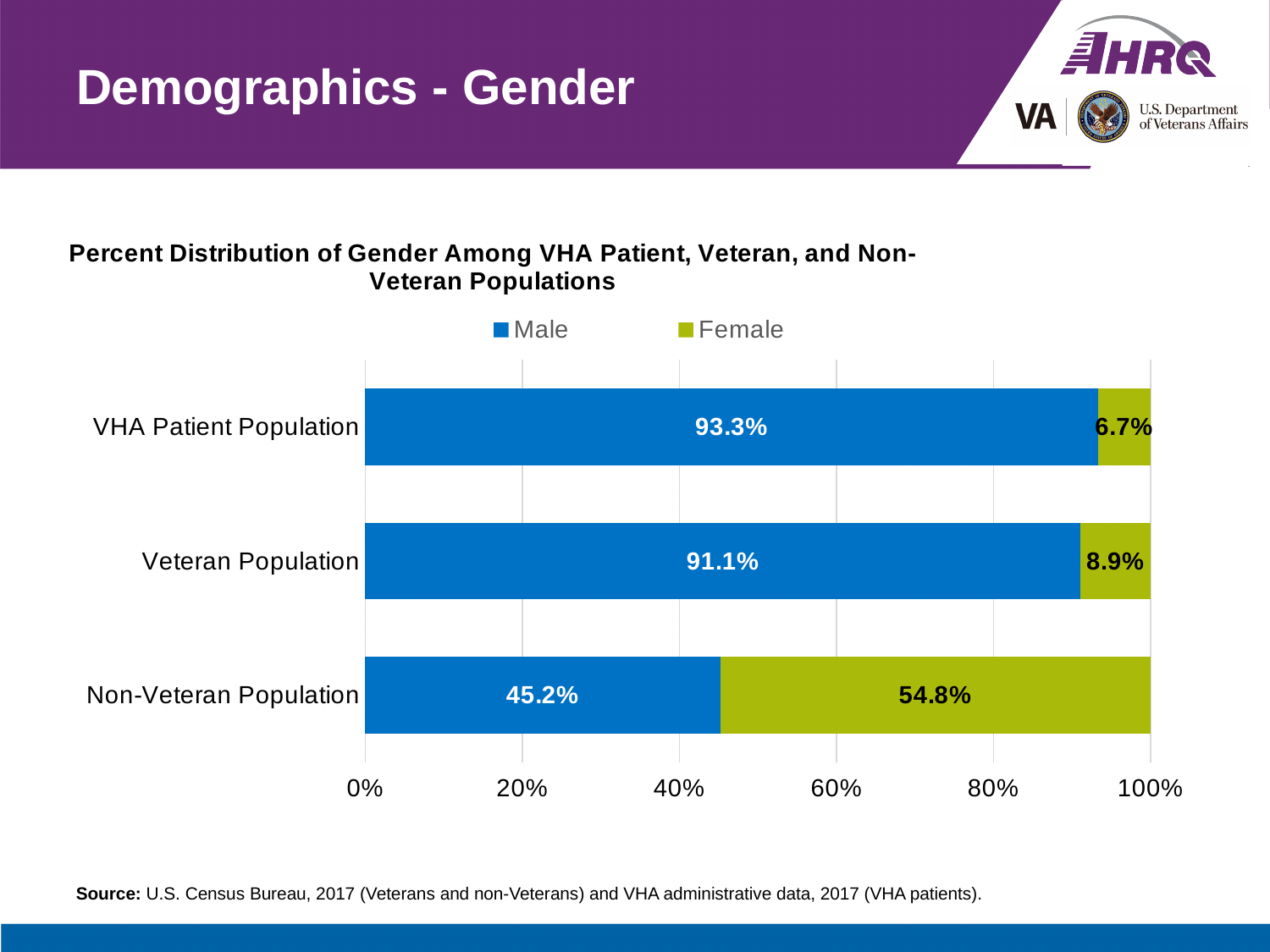
Which population has the lowest Female percentage? VHA Patient Population Is the Male value for the Non-Veteran Population greater or less than 40%? greater Which colour represents Female in the chart? Green Which population has the highest Male percentage? VHA Patient Population What kind of chart is shown on the slide? Stacked bar chart What is the difference between the Male percentages of the Veteran Population and the Non-Veteran Population? 45.9% How many populations are shown on the chart? 3 What is the Male percentage for the VHA Patient Population? 93.3% What is the Female percentage for the Non-Veteran Population? 54.8% How many series does the legend list? 2 What is the Female percentage for the Veteran Population? 8.9% Which is larger: the Female percentage for the Veteran Population or for the VHA Patient Population? Veteran Population